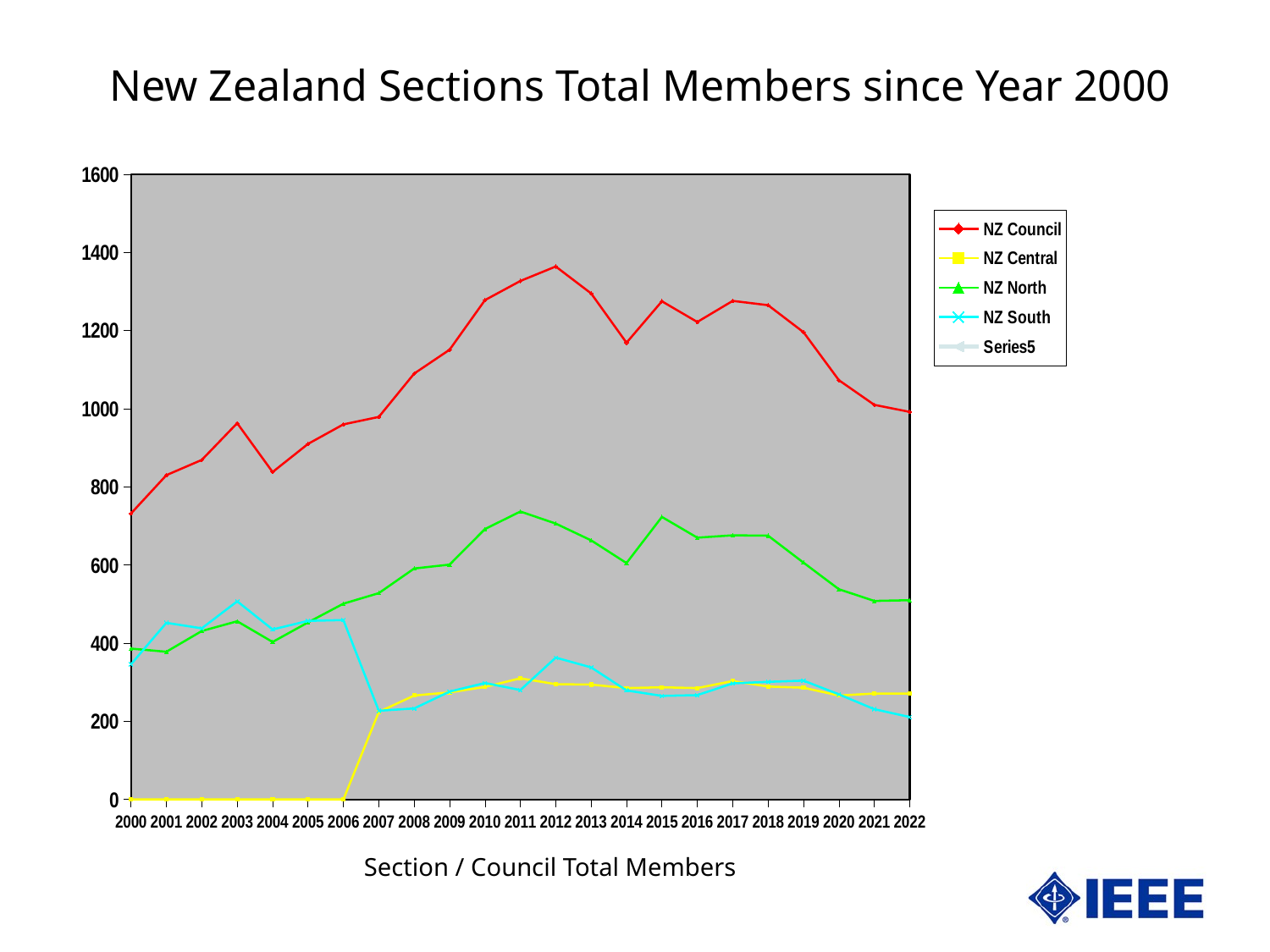
What value does the NZ Central series show for the years 2000 to 2006? 0 Is the value for NZ North in 2011 greater or less than 600? greater Is the value for NZ Council in 2012 greater or less than 1200? greater Does the NZ Council series rise or fall from 2012 to 2022? fall How many series does the legend list? 5 In which year does the NZ Council series reach its highest value? 2012 Which series has the larger value in 2012, NZ Council or NZ North? NZ Council What is the title of the chart? New Zealand Sections Total Members since Year 2000 How many years are plotted along the x axis? 23 Is the value for NZ Council in 2000 greater or less than 800? less Which colour is used for the NZ North series? green What kind of chart is shown on the slide? line chart